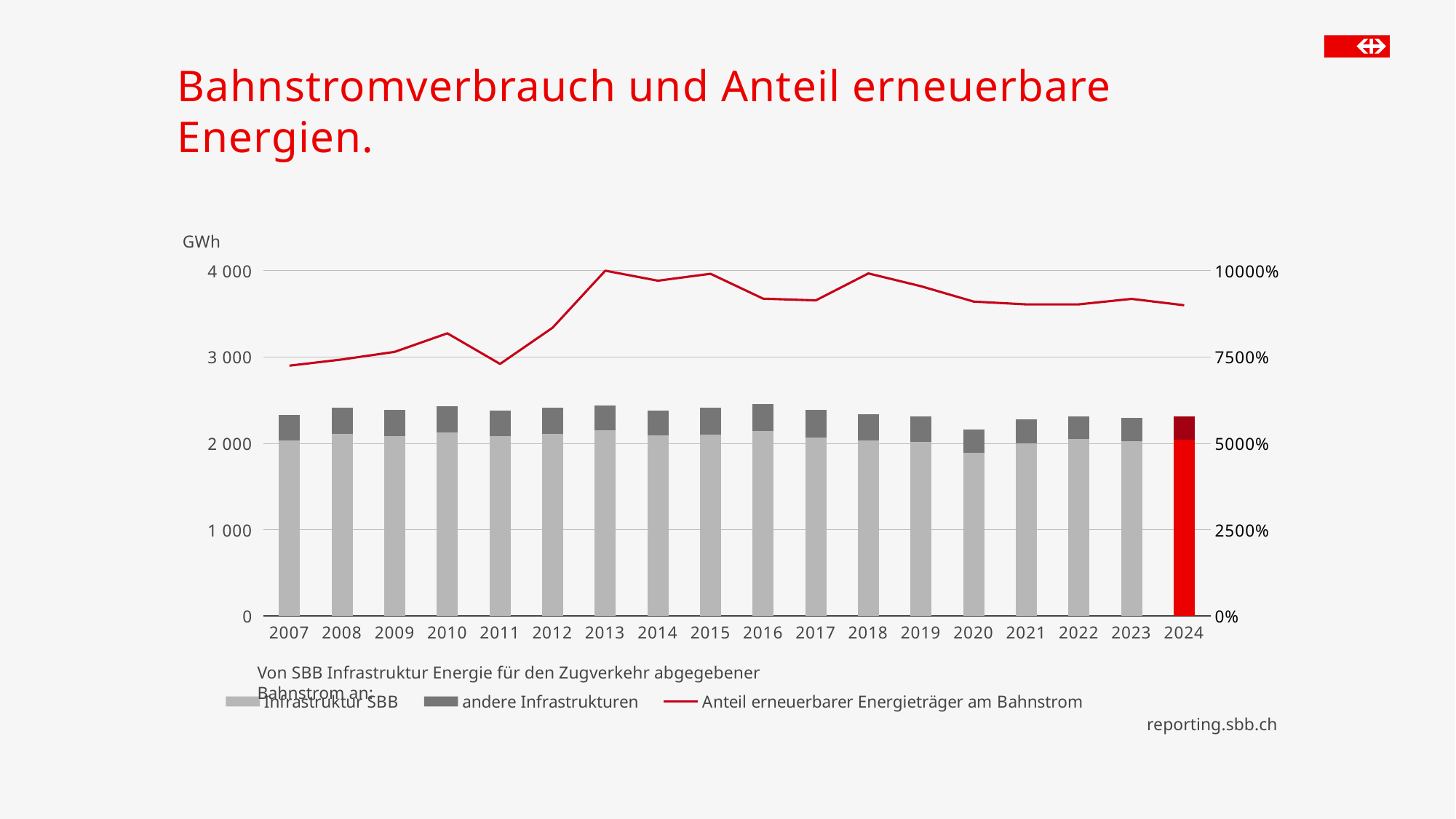
How many series does the chart legend list? 3 Which year has the lowest total bar (Bahnstrom in GWh)? 2020 Which year's bar is highlighted in red? 2024 Is the value of the line 'Anteil erneuerbarer Energieträger am Bahnstrom' for 2013 greater or less than 7500%? greater What kind of chart is shown on the slide? Stacked bar chart with a line Which is larger: the total bar for 2016 or the total bar for 2020? 2016 Does the line 'Anteil erneuerbarer Energieträger am Bahnstrom' rise or fall from 2011 to 2013? rise What is the title of the chart on the slide? Bahnstromverbrauch und Anteil erneuerbare Energien. How many years are shown on the x axis of the chart? 18 Is the value of the line 'Anteil erneuerbarer Energieträger am Bahnstrom' for 2011 greater or less than 7500%? less Is the total bar for 2020 greater or less than 2 000 GWh? greater